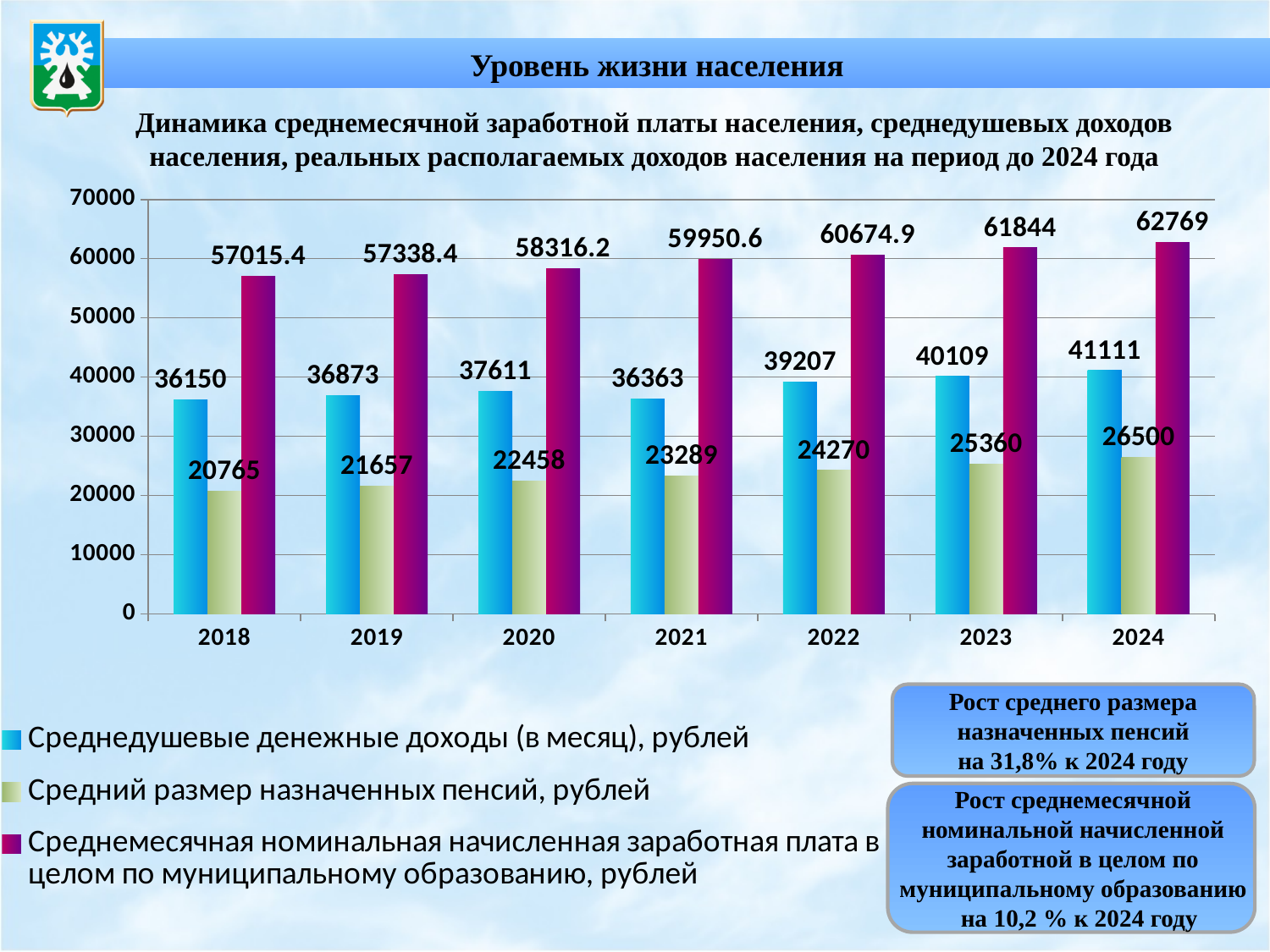
How many series does the legend list? 3 What is the value of Средний размер назначенных пенсий in 2023? 25360 What is the value of Среднемесячная номинальная начисленная заработная плата in 2020? 58316.2 How many years are shown on the x axis of the chart? 7 Does Средний размер назначенных пенсий rise or fall from 2018 to 2024? Rises What is the difference between Среднемесячная номинальная начисленная заработная плата in 2024 and in 2023? 925 Which year has the larger value of Среднедушевые денежные доходы, 2019 or 2021? 2019 What kind of chart is shown on the slide? Bar chart What is the value of Среднедушевые денежные доходы in 2021? 36363 In which year is Средний размер назначенных пенсий the lowest? 2018 In which year is Среднемесячная номинальная начисленная заработная плата the highest? 2024 By how much does Средний размер назначенных пенсий in 2024 exceed its value in 2018? 5735